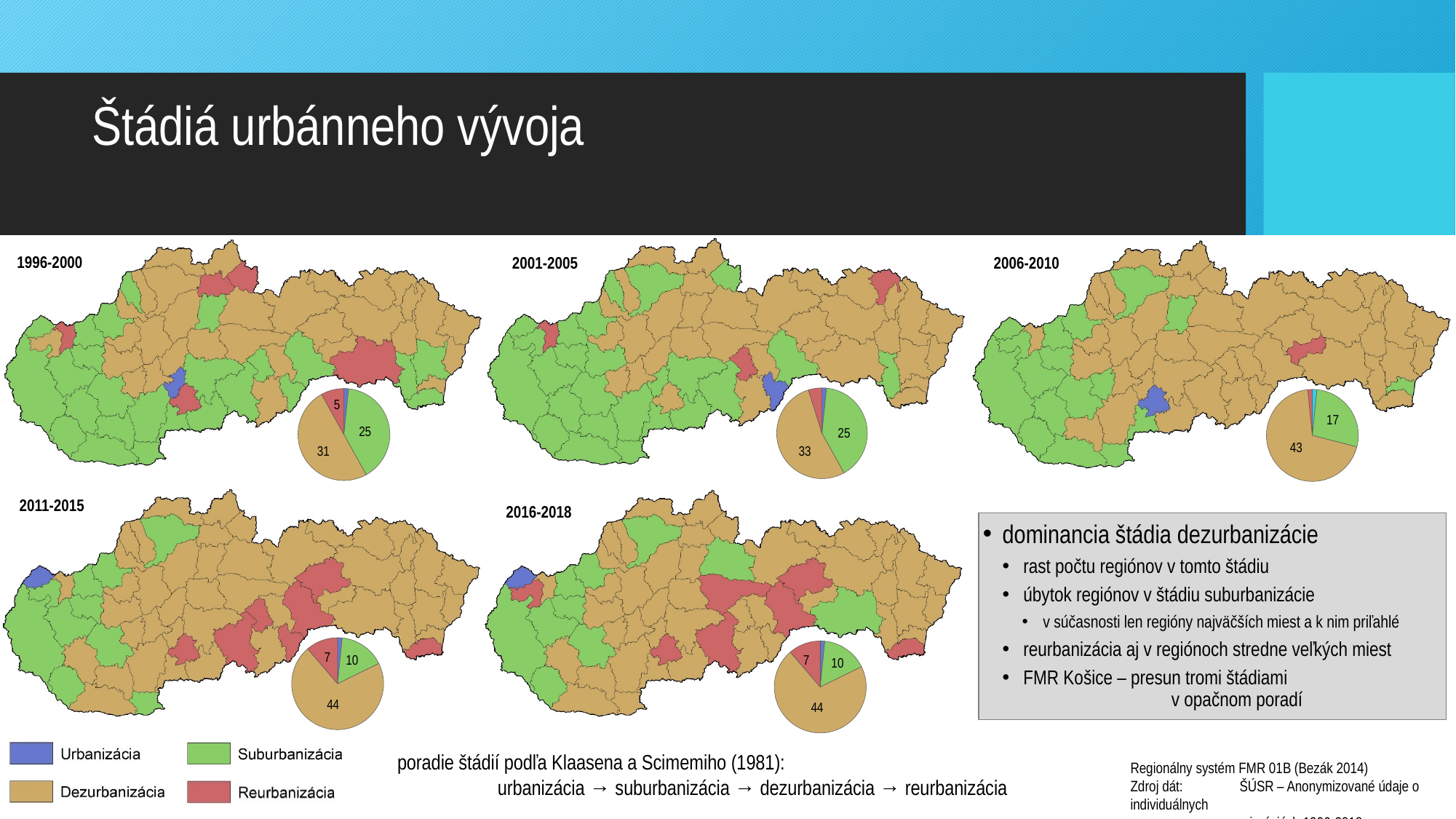
In the pie chart for 1996-2000, what value is shown for the Suburbanizácia slice? 25 In the pie chart for 2006-2010, what is the difference between the Dezurbanizácia value and the Suburbanizácia value? 26 How many pie charts are on the slide? 5 In the pie chart for 2011-2015, which stage has the largest slice? Dezurbanizácia In the pie chart for 2006-2010, what value is shown for the Suburbanizácia slice? 17 How many stages does the legend at the bottom left list? 4 In the pie chart for 2001-2005, what value is shown for the Dezurbanizácia slice? 33 In the pie chart for 1996-2000, which is larger, the Dezurbanizácia slice or the Suburbanizácia slice? Dezurbanizácia In the pie chart for 1996-2000, what value is shown for the Reurbanizácia slice? 5 In the pie chart for 2016-2018, what is the difference between the Dezurbanizácia value and the Suburbanizácia value? 34 In the pie chart for 1996-2000, what value is shown for the Dezurbanizácia slice? 31 What kind of chart is shown next to each map? Pie chart